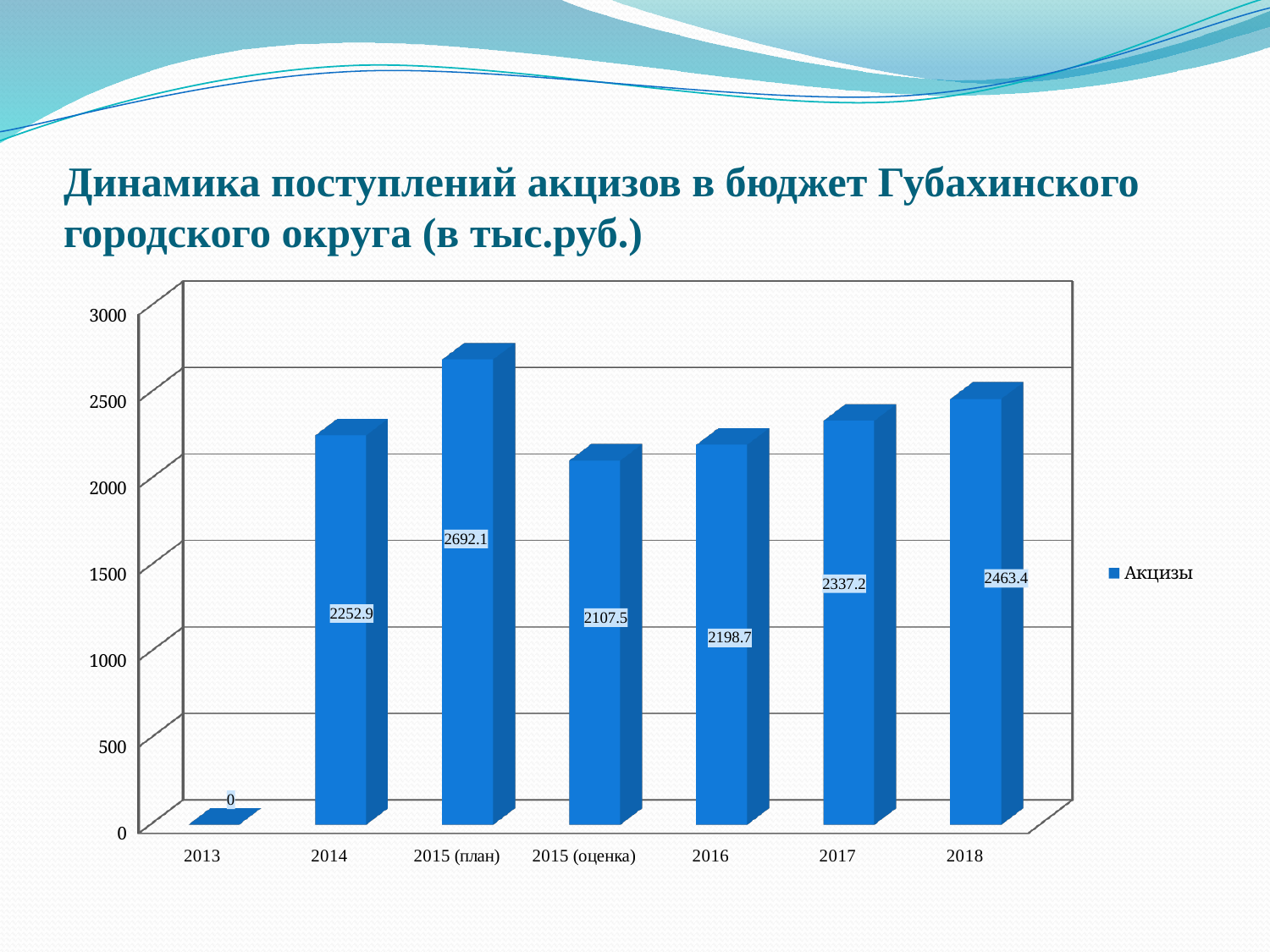
What is the value for 2015 (оценка)? 2107.5 What is the value for 2018? 2463.4 How many series does the legend list? 1 What is the value for 2014? 2252.9 Which is larger, the value for 2017 or the value for 2016? 2017 What is the difference between the values for 2015 (план) and 2015 (оценка)? 584.6 Which category has the lowest value? 2013 What is the value for 2015 (план)? 2692.1 Is the value for 2018 greater or less than 2500? less What kind of chart is shown on the slide? bar chart How many categories are shown on the x axis? 7 Which category has the highest value? 2015 (план)